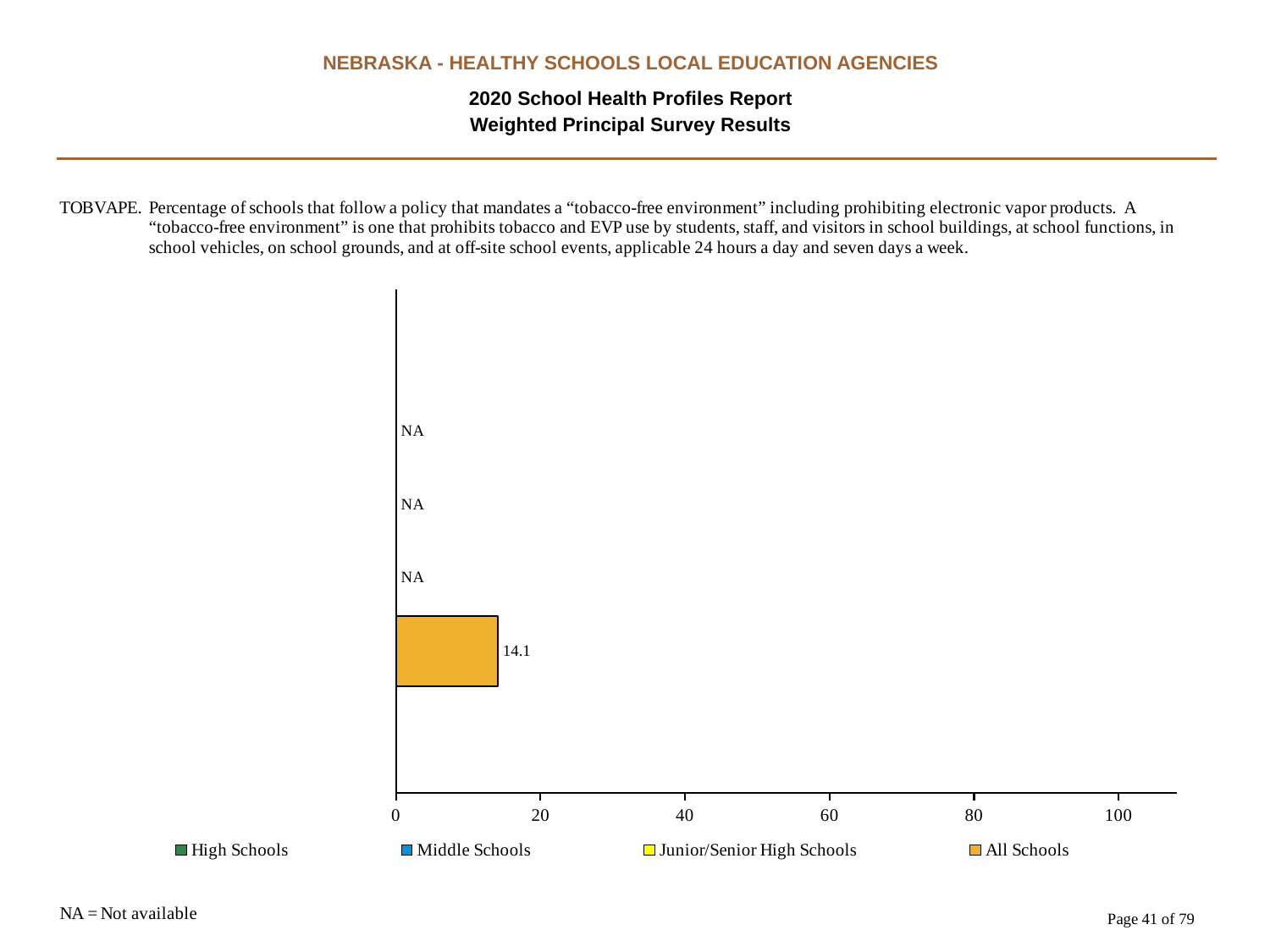
What kind of chart is shown on the slide? bar chart What value is shown for Junior/Senior High Schools? NA How many of the school groups have a plotted bar rather than NA? 1 What is the maximum value shown on the x axis? 100 What value is shown for High Schools? NA How many series does the legend list? 4 Which school group is the only one with a plotted value? All Schools What is the value for All Schools? 14.1 What value is shown for Middle Schools? NA According to the note on the slide, what does NA stand for? Not available Is the value for All Schools greater or less than 20? less